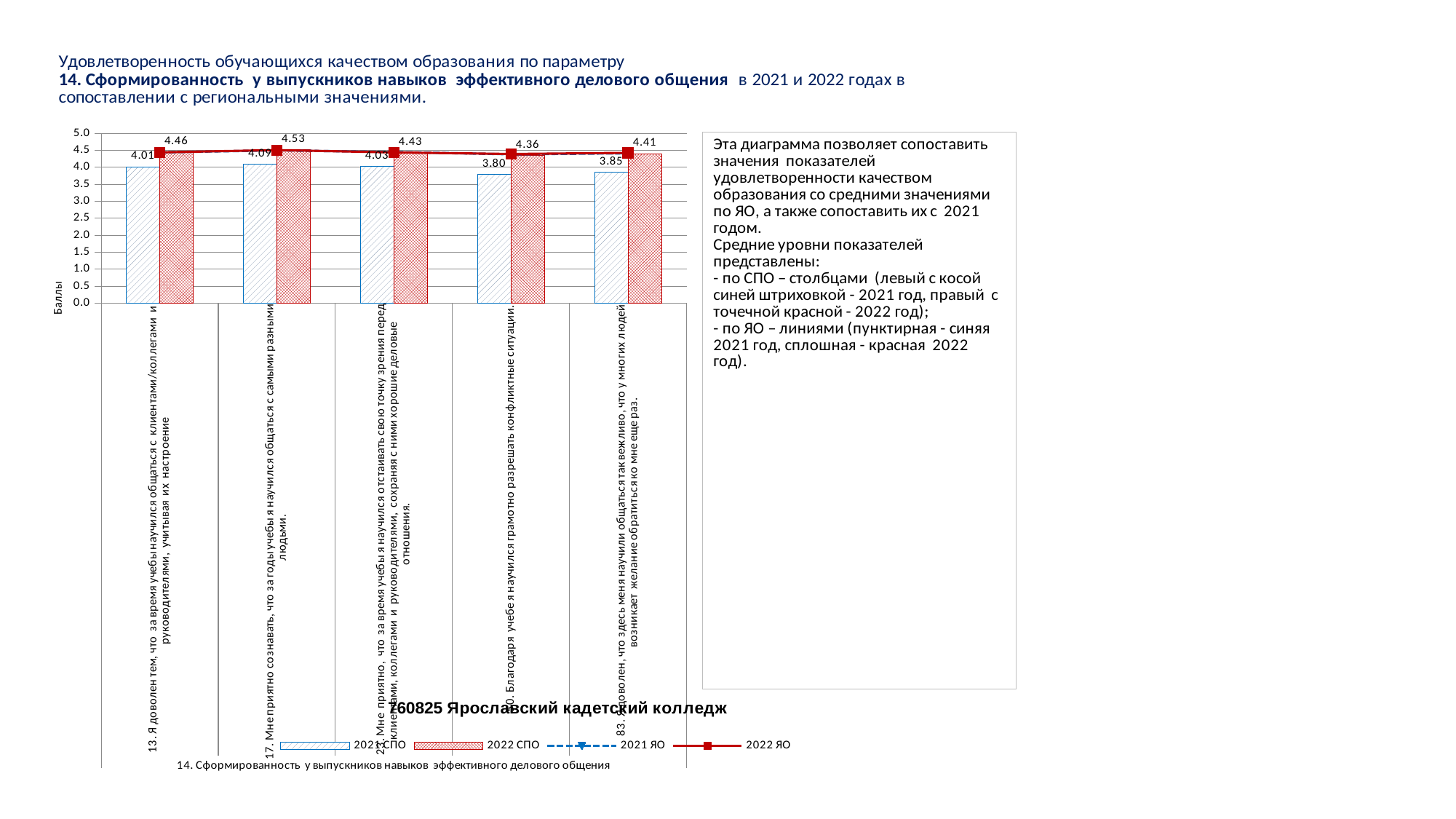
For statement 17, how much higher is the 2022 СПО value than the 2021 СПО value? 0.44 What is the 2021 СПО value for statement 13 ("Я доволен тем, что за время учебы научился общаться с клиентами/коллегами и руководителями...")? 4.01 For statement 83, what is the difference between the 2022 СПО and 2021 СПО values? 0.56 What is the 2022 СПО value for statement 83 ("Я доволен, что здесь меня научили общаться так вежливо...")? 4.41 How many statements (categories) are plotted on the chart? 5 Which statement has the lowest 2021 СПО value? Благодаря учебе я научился грамотно разрешать конфликтные ситуации (3.80) Is the 2022 ЯО line value for statement 13 greater or less than 4.0? greater How many series does the chart legend list? 4 Which statement has the highest 2022 СПО value? 17. Мне приятно сознавать, что за годы учебы я научился общаться с самыми разными людьми (4.53) What kind of chart is shown on the slide? A combined bar and line chart Which is larger: the 2021 СПО value for statement 13 or for statement 83? Statement 13 (4.01) What is the 2021 СПО value for statement 17 ("Мне приятно сознавать, что за годы учебы я научился общаться с самыми разными людьми")? 4.09